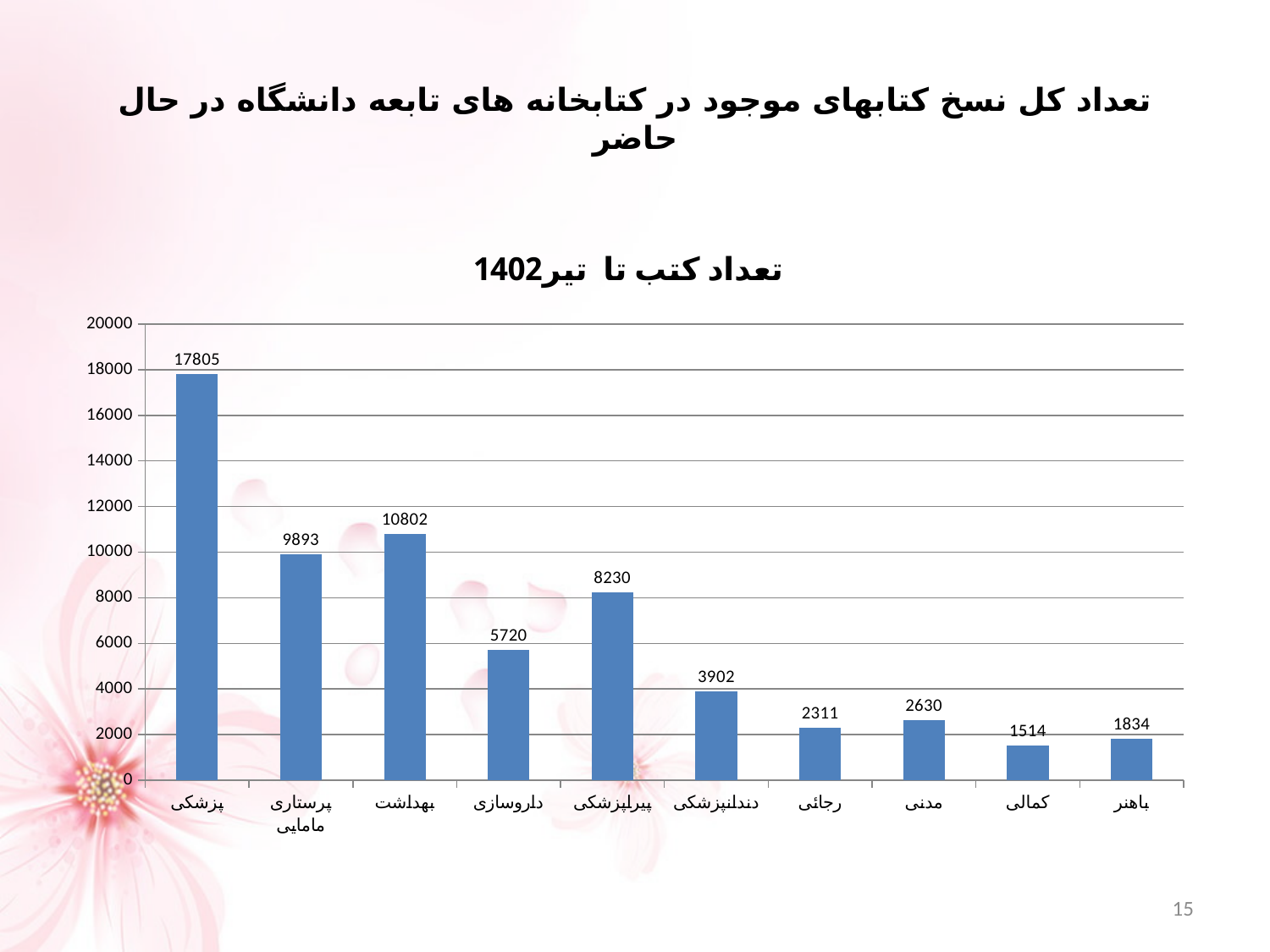
What is the value for بهداشت? 10802 Is the value for پیراپزشکی greater or less than 8000? greater Which category has the highest value? پزشکی Which is larger, the value for بهداشت or the value for پرستاری مامایی? بهداشت What is the difference between the values for پزشکی and بهداشت? 7003 What is the title of the chart? تعداد کتب تا تیر1402 What is the difference between the values for مدنی and رجائی? 319 What is the value for پزشکی? 17805 What is the value for دندانپزشکی? 3902 What kind of chart is shown on the slide? bar chart Which category has the lowest value? کمالی How many categories are shown on the x axis? 10